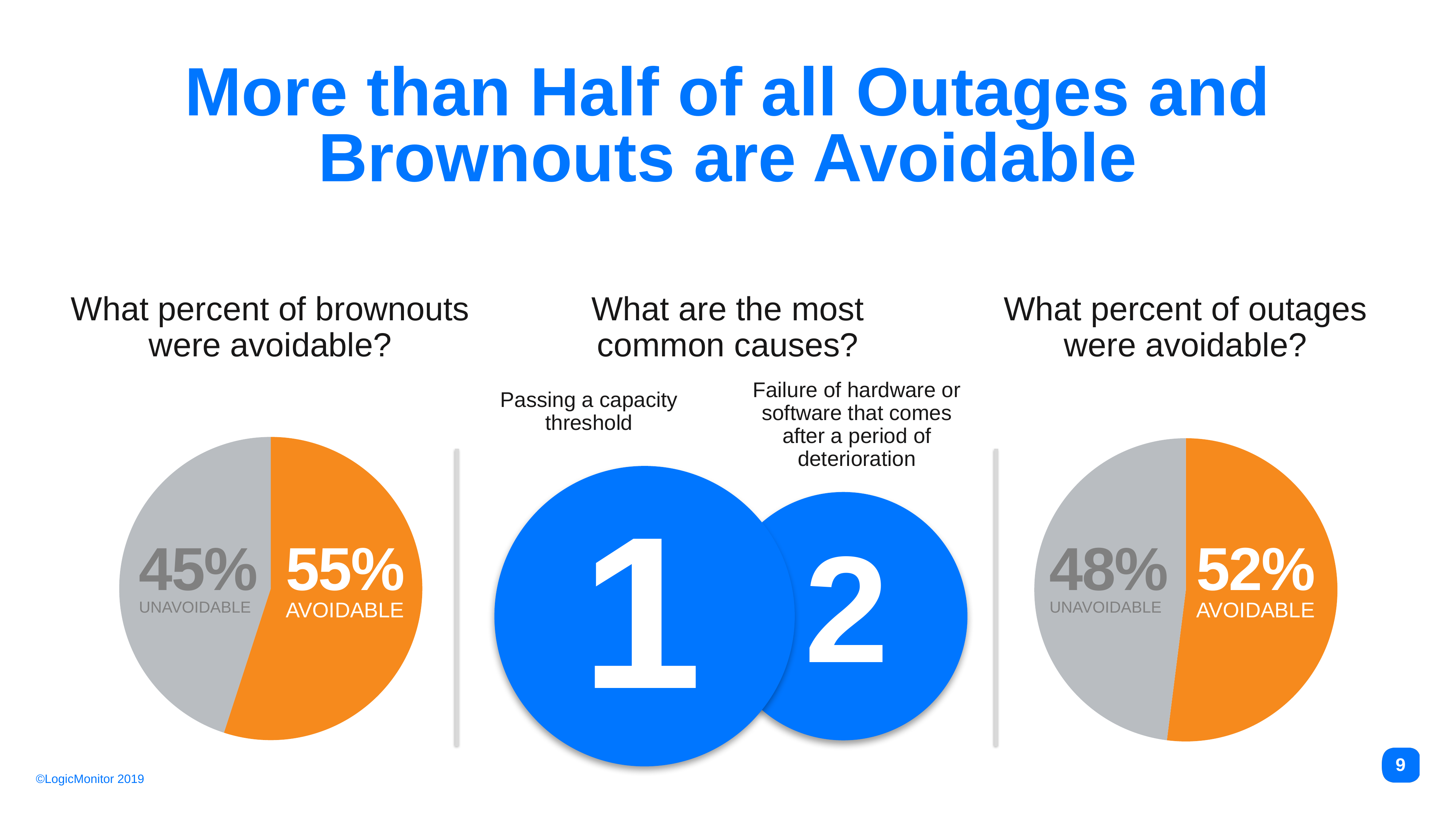
How many slices does the right pie chart (outages) have? 2 In the right pie chart (outages), which slice is smaller, avoidable or unavoidable? Unavoidable In the left pie chart (brownouts), what percent of brownouts were avoidable? 55% In the right pie chart (outages), what percent of outages were unavoidable? 48% What kind of chart is used to show the percent of brownouts that were avoidable? Pie chart In the left pie chart (brownouts), what is the difference between the avoidable and unavoidable percentages? 10% In the left pie chart (brownouts), which slice is larger, avoidable or unavoidable? Avoidable In the right pie chart (outages), what percent of outages were avoidable? 52% In the right pie chart (outages), what is the difference between the avoidable and unavoidable percentages? 4% Which is larger: the avoidable share of brownouts in the left pie chart or the avoidable share of outages in the right pie chart? Avoidable share of brownouts (55%) In the left pie chart (brownouts), what colour is the avoidable slice? Orange In the left pie chart (brownouts), what percent of brownouts were unavoidable? 45%